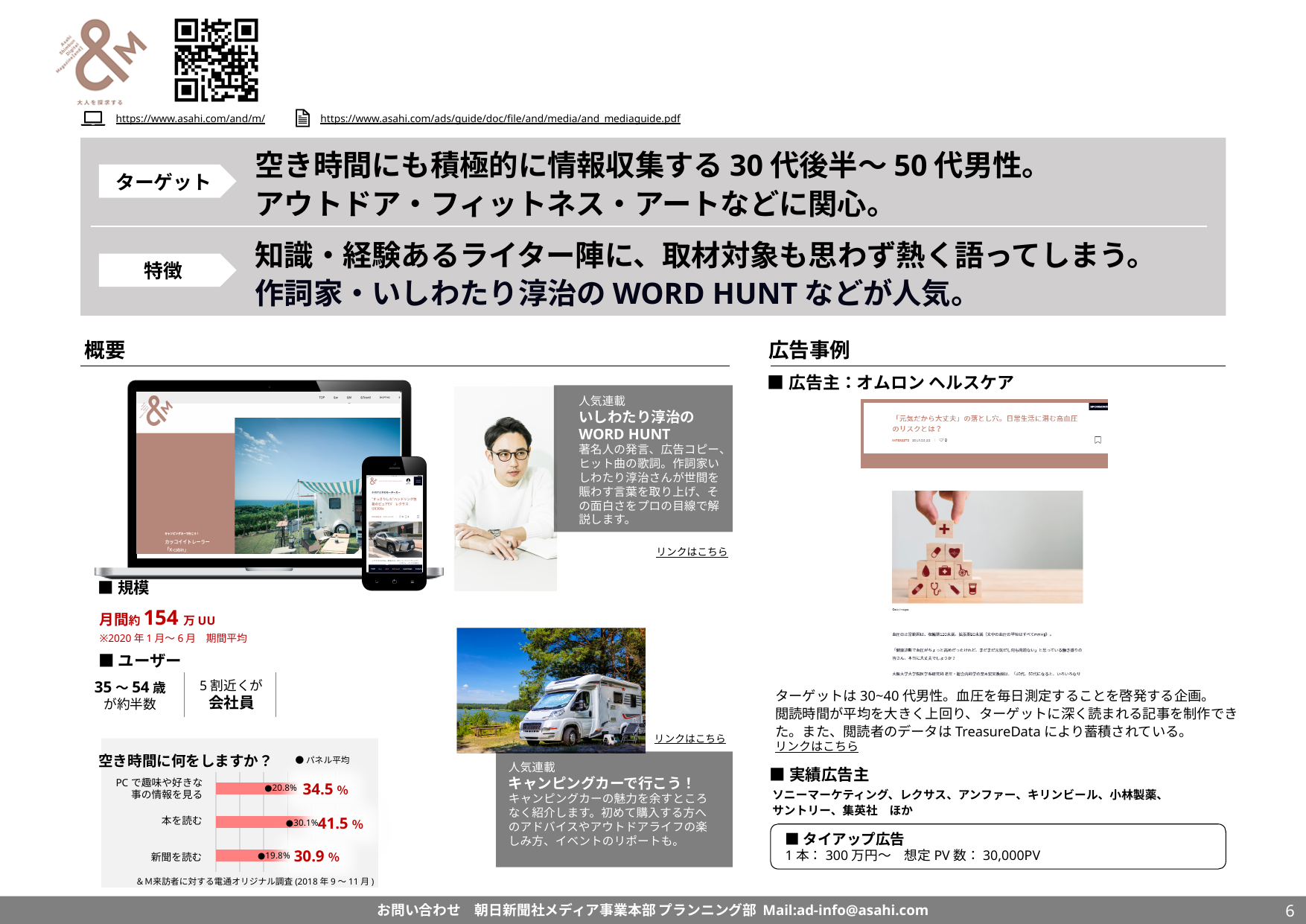
What is the title of the bar chart on the slide? 空き時間に何をしますか？ In the "空き時間に何をしますか？" chart, what is the difference between the value for 本を読む and the value for 新聞を読む? 10.6 % In the "空き時間に何をしますか？" chart, which is larger: the value for PCで趣味や好きな事の情報を見る or the value for 本を読む? 本を読む In the "空き時間に何をしますか？" chart, what is the パネル平均 value for 本を読む? 30.1% In the "空き時間に何をしますか？" chart, what is the value for 新聞を読む? 30.9 % In the "空き時間に何をしますか？" chart, which category has the highest value? 本を読む In the "空き時間に何をしますか？" chart, which category has the lowest value? 新聞を読む What kind of chart is "空き時間に何をしますか？"? bar chart In the "空き時間に何をしますか？" chart, what is the パネル平均 value for 新聞を読む? 19.8% In the "空き時間に何をしますか？" chart, what is the value for PCで趣味や好きな事の情報を見る? 34.5 % In the "空き時間に何をしますか？" chart, what is the value for 本を読む? 41.5 % How many categories are shown in the "空き時間に何をしますか？" chart? 3